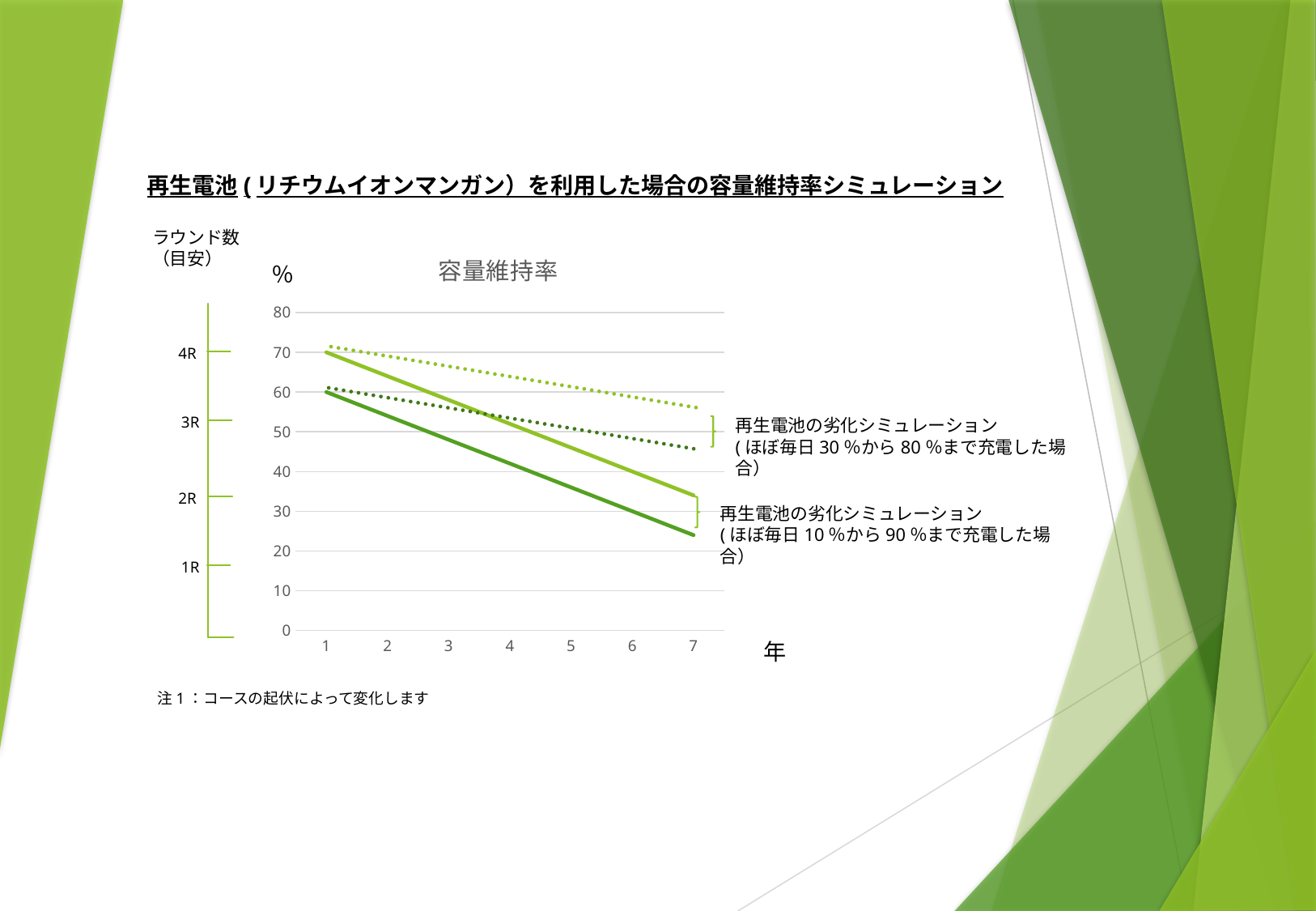
Do the lines on the chart rise or fall from year 1 to year 7? fall Which pair of lines is higher on the chart: the dotted lines (30%から80%まで充電した場合) or the solid lines (10%から90%まで充電した場合)? the dotted lines What kind of chart is shown on the slide? line chart Is the value of the light green solid line at year 4 greater or less than 60? less What is the highest value shown on the y axis of the chart? 80 Is the value of the dark green solid line at year 7 greater or less than 30? less Is the value of the light green dotted line at year 7 greater or less than 50? greater How many points are on the x axis of the chart? 7 How many lines are plotted on the chart? 4 What is the title of the chart? 容量維持率 At year 7, which is higher: the light green dotted line or the dark green solid line? the light green dotted line